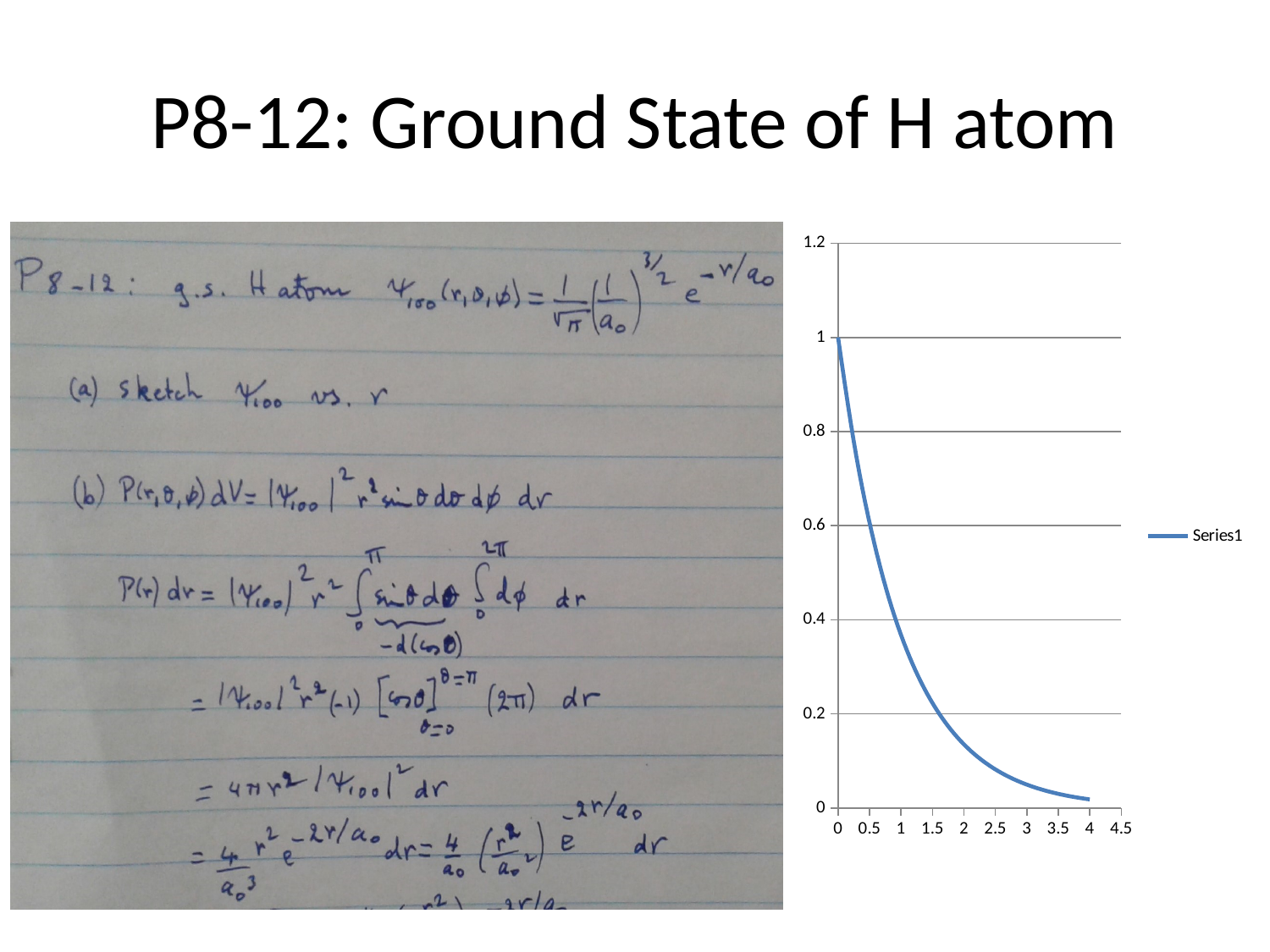
Is the value of Series1 at x = 3 greater or less than 0.2? less What kind of chart is shown on the right side of the slide? line chart What is the highest value shown on the y axis of the chart? 1.2 What is the name of the series shown in the chart legend? Series1 At which x value does Series1 reach its highest value? 0 How many series does the chart legend list? 1 Is the value of Series1 at x = 2 greater or less than 0.2? less Is the value of Series1 at x = 0.25 greater or less than 0.6? greater Which is larger: the value of Series1 at x = 1 or at x = 3? x = 1 What is the value of Series1 at x = 0? 1 Do the values of Series1 rise or fall as x increases along the x axis? fall